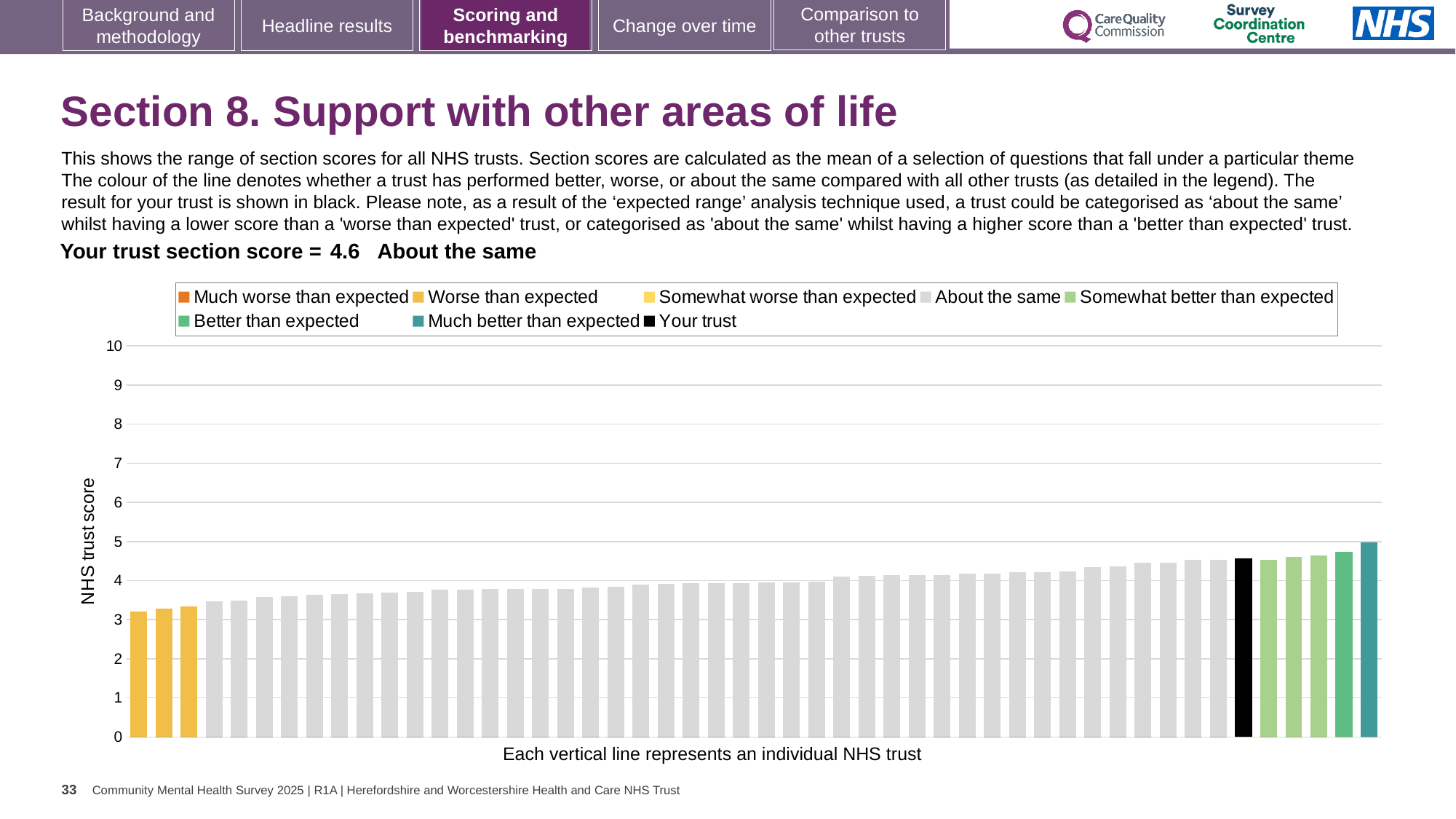
Do the bar values rise or fall from left to right along the x axis? rise Which performance category is your trust placed in for this section? About the same What is the label on the vertical axis of the chart? NHS trust score Is the value of the lowest bar in the chart greater or less than 4? less What kind of chart is shown on the slide? bar chart How many entries does the chart legend list? 8 Is the value of the highest bar in the chart greater or less than 6? less Is the value for your trust (the black bar) greater or less than 4? greater Which legend category does the highest bar in the chart belong to? Much better than expected How many bars are coloured as 'Worse than expected'? 3 How many bars are coloured as 'Much better than expected'? 1 What is the section score for your trust shown on the slide? 4.6